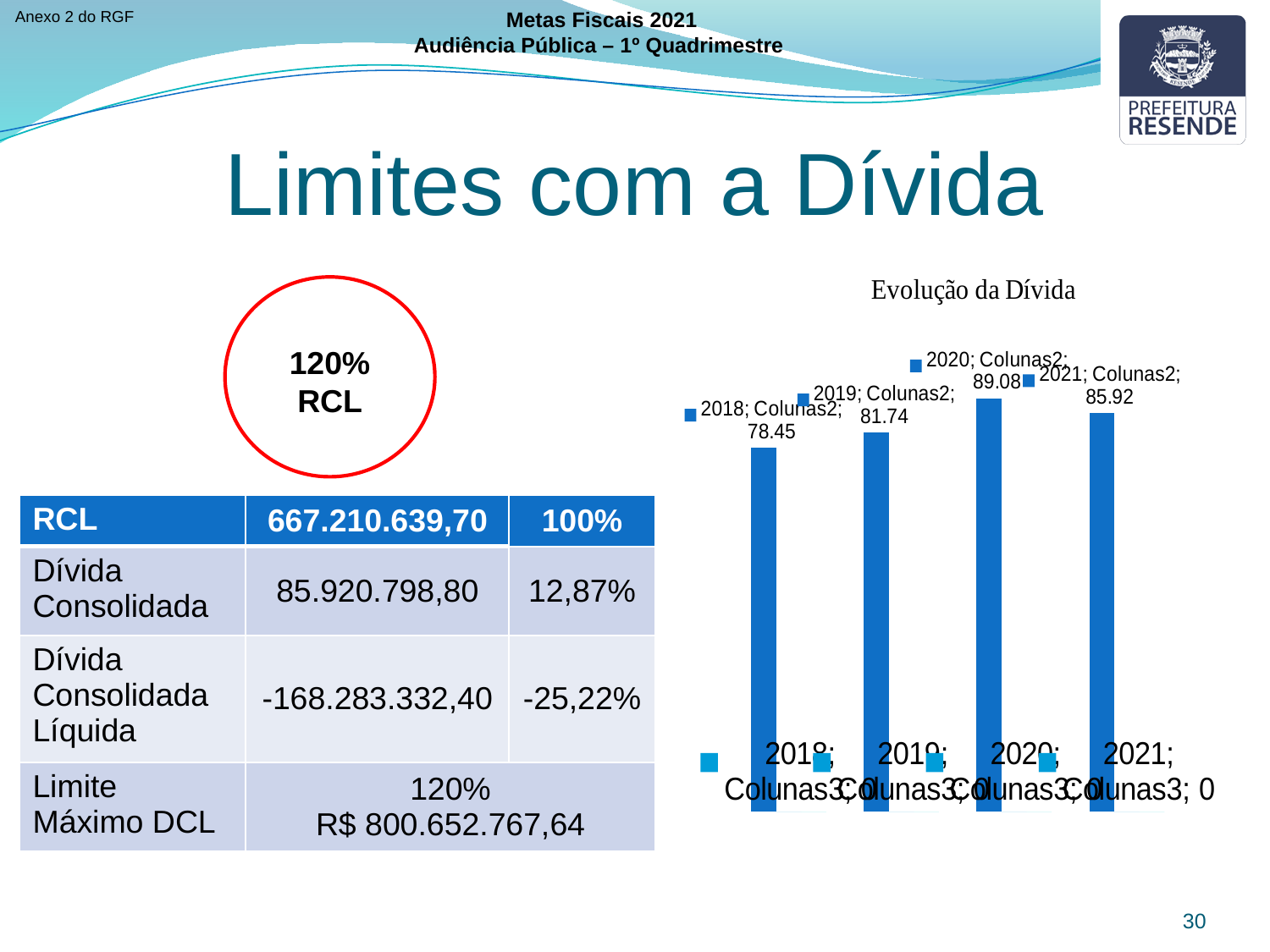
In the "Evolução da Dívida" chart, what is the value for 2021? 85.92 How many years are shown on the x axis of the "Evolução da Dívida" chart? 4 What is the title of the chart on the slide? Evolução da Dívida In the "Evolução da Dívida" chart, what is the value for 2019? 81.74 In the "Evolução da Dívida" chart, what is the difference between the values for 2020 and 2018? 10.63 In the "Evolução da Dívida" chart, which year has the lowest value? 2018 In the "Evolução da Dívida" chart, do the values rise or fall from 2018 to 2020? rise In the "Evolução da Dívida" chart, which is larger, the value for 2021 or the value for 2019? 2021 In the "Evolução da Dívida" chart, what is the value for 2020? 89.08 In the "Evolução da Dívida" chart, which year has the highest value? 2020 What type of chart is "Evolução da Dívida"? bar chart In the "Evolução da Dívida" chart, what is the value for 2018? 78.45